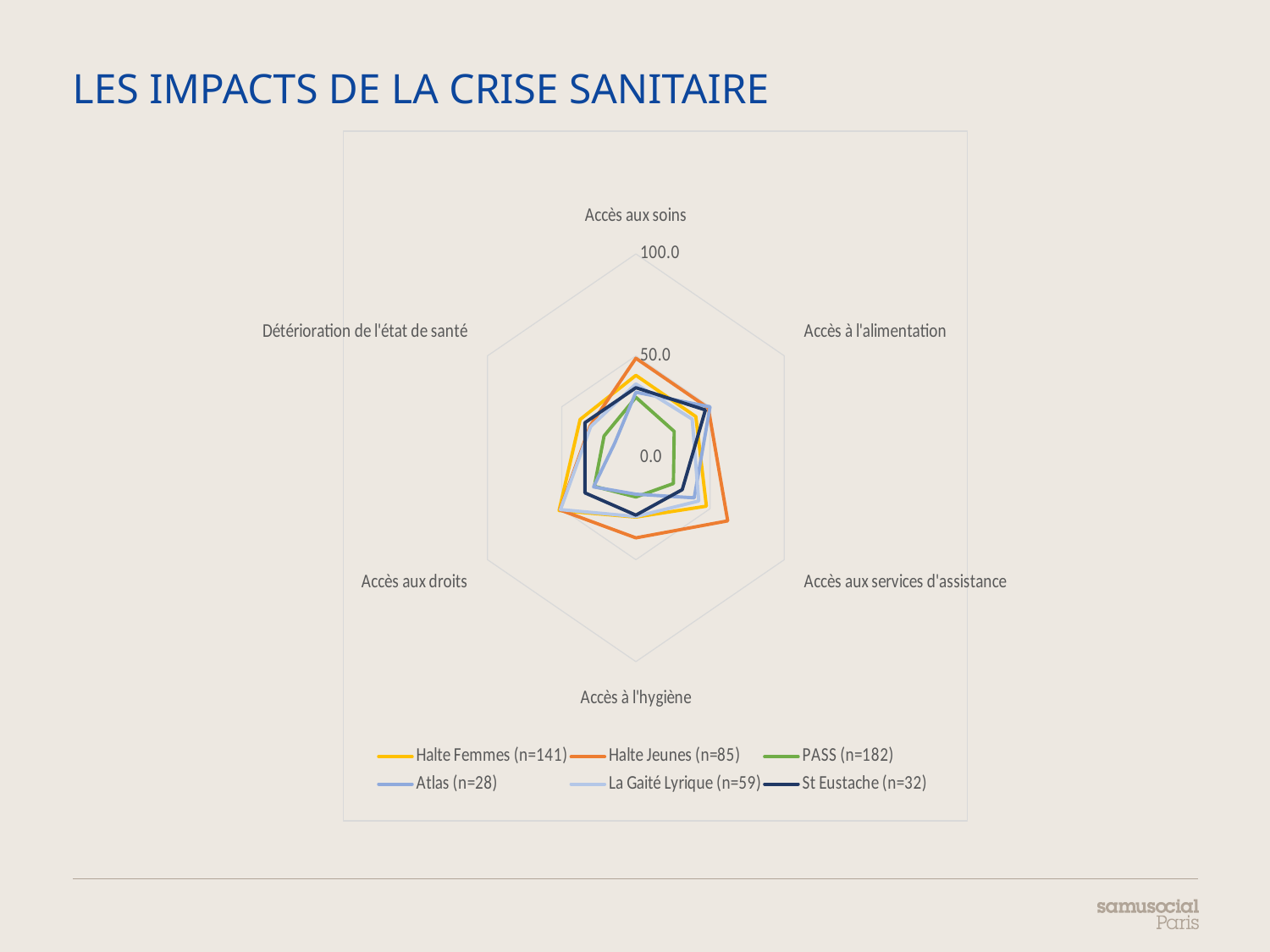
Which series has the lowest value for Accès à l'hygiène? Atlas (n=28) How many series does the legend list? 6 What is the title of the slide containing the chart? LES IMPACTS DE LA CRISE SANITAIRE Is the value for Halte Jeunes (n=85) on Accès à l'hygiène greater or less than 50? less Is the value for PASS (n=182) on Accès aux soins greater or less than 50? less For Accès à l'hygiène, which is larger: the value for Halte Jeunes (n=85) or for PASS (n=182)? Halte Jeunes (n=85) Is the value for Halte Jeunes (n=85) on Accès aux soins greater or less than 100? less How many categories (axes) does the radar chart have? 6 What kind of chart is shown on the slide? Radar chart Which series has the highest value for Accès à l'hygiène? Halte Jeunes (n=85) What is the maximum value shown on the radar chart's axis scale? 100.0